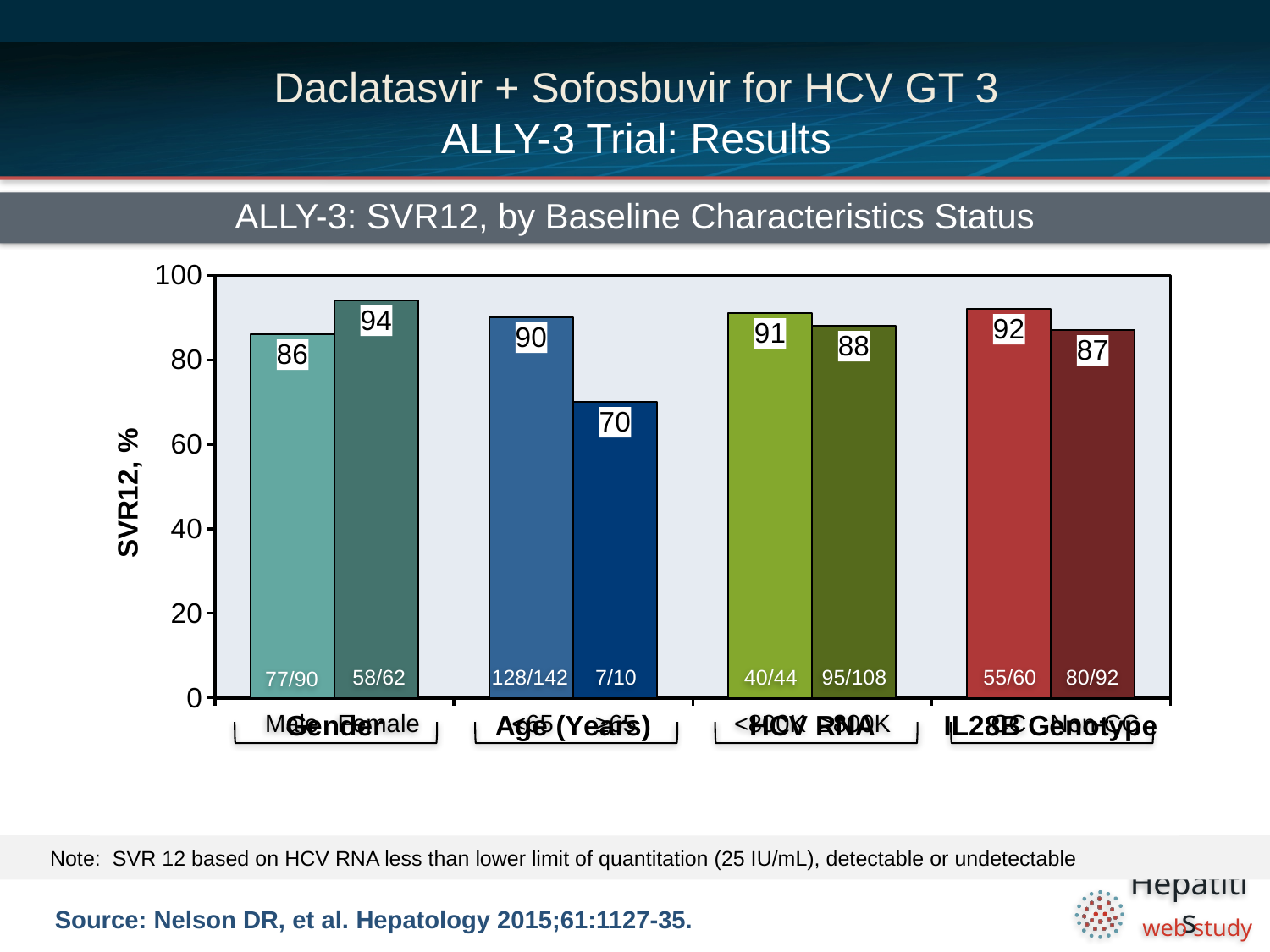
Which bar has the lowest SVR12 value? the second bar in the Age (Years) group (7/10) What is the SVR12 value for the second bar in the IL28B Genotype group (80/92)? 87 What is the difference in SVR12 between the two bars in the Age (Years) group? 20 Which bar has the highest SVR12 value? the second bar in the Gender group (58/62) How many baseline characteristic groups are shown along the x axis? 4 What kind of chart is shown on the slide? bar chart In the HCV RNA group, which bar has the larger SVR12 value, the first (40/44) or the second (95/108)? the first (40/44) What is the SVR12 value for the second bar in the Gender group (58/62)? 94 How many bars are plotted in the chart? 8 What is the SVR12 value for the first bar in the Gender group (77/90)? 86 What is the SVR12 value for the bar labelled 7/10 in the Age (Years) group? 70 What is the title of the y axis? SVR12, %